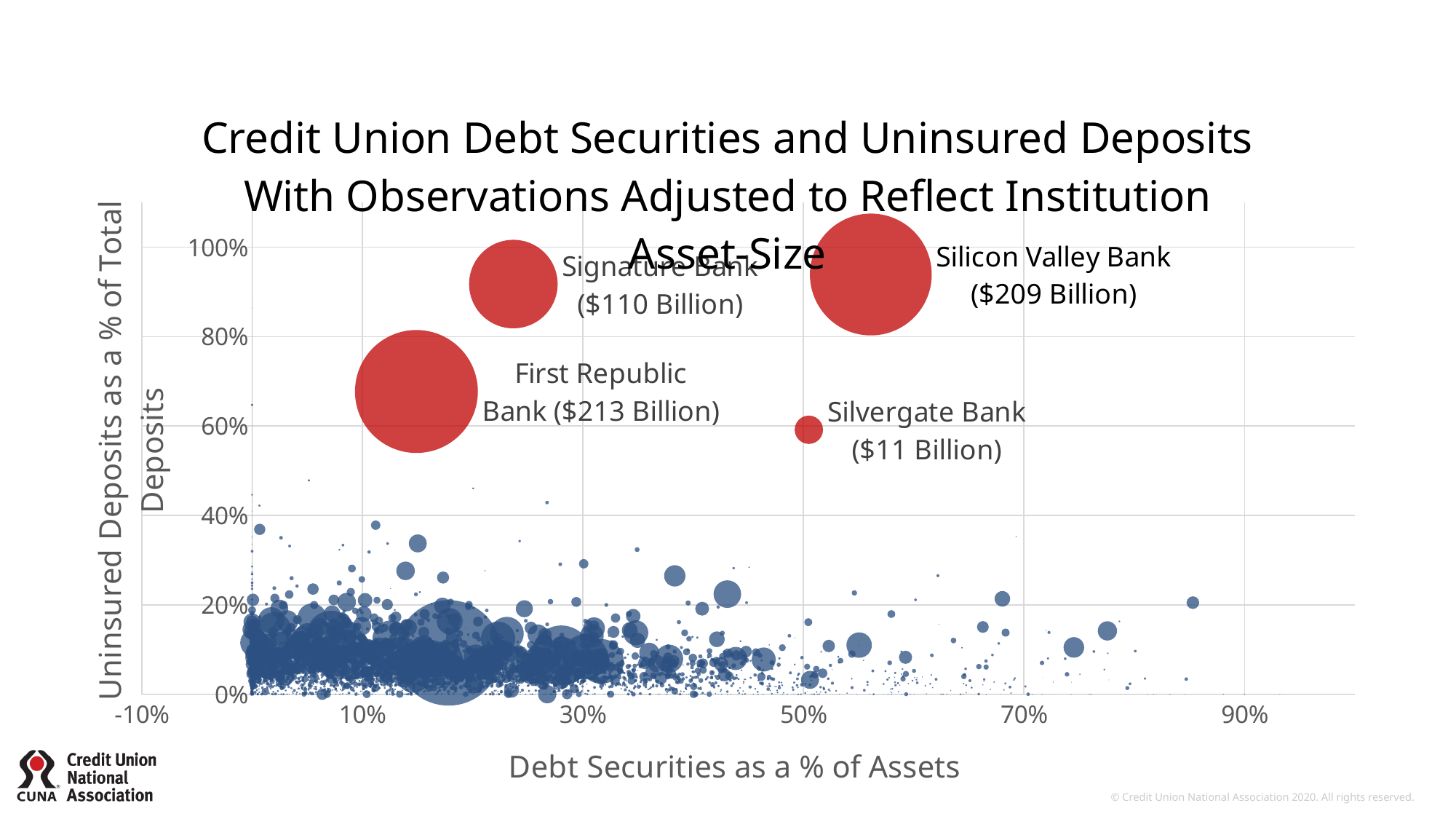
Is the uninsured deposits percentage for Silvergate Bank greater or less than 40%? greater Which of the labeled banks has the largest printed asset size? First Republic Bank What asset size is printed for Silvergate Bank? $11 Billion How many banks are labeled with red bubbles on the chart? 4 What asset size is printed for Silicon Valley Bank? $209 Billion What asset size is printed for Signature Bank? $110 Billion What kind of chart is shown on the slide? bubble chart Is the uninsured deposits percentage for First Republic Bank greater or less than 80%? less Which of the labeled banks has the smallest printed asset size? Silvergate Bank What asset size is printed for First Republic Bank? $213 Billion What is the difference between the printed asset sizes of First Republic Bank and Silicon Valley Bank? $4 Billion Which bank has a higher debt securities percentage of assets, Silicon Valley Bank or Signature Bank? Silicon Valley Bank